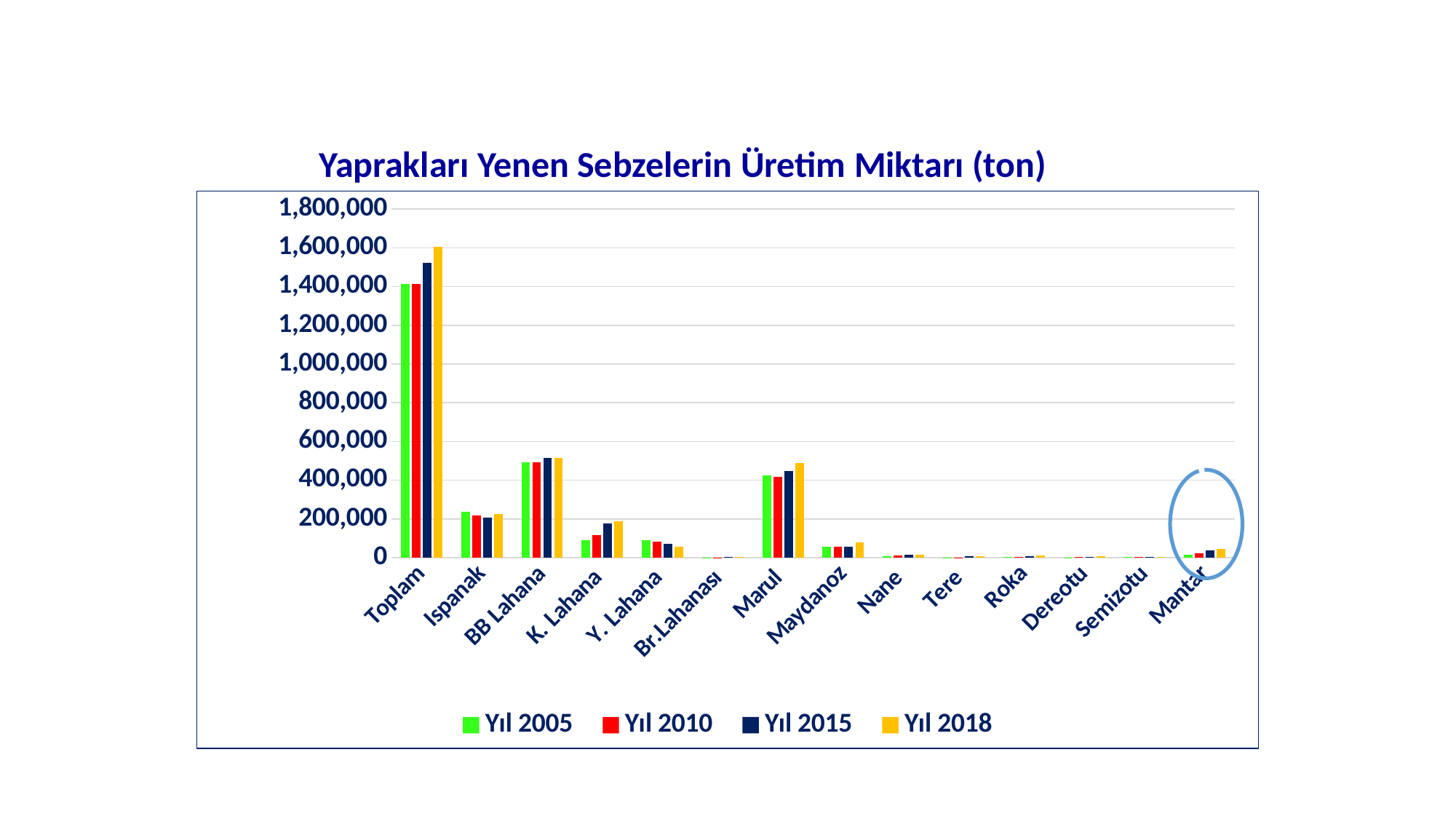
Is the Yıl 2015 value for Toplam greater or less than 1,400,000? greater How many categories are shown on the x axis? 14 Is the Yıl 2018 value for Marul greater or less than 600,000? less Is the Yıl 2005 value for K. Lahana greater or less than 200,000? less Which category has the highest bars in the chart? Toplam Do the values for K. Lahana rise or fall from Yıl 2005 to Yıl 2018? rise Which category has the larger Yıl 2018 value: Ispanak or K. Lahana? Ispanak What kind of chart is shown on the slide? Bar chart How many series does the legend list? 4 What is the title of the chart? Yaprakları Yenen Sebzelerin Üretim Miktarı (ton) Which is larger for Toplam: the Yıl 2005 value or the Yıl 2018 value? Yıl 2018